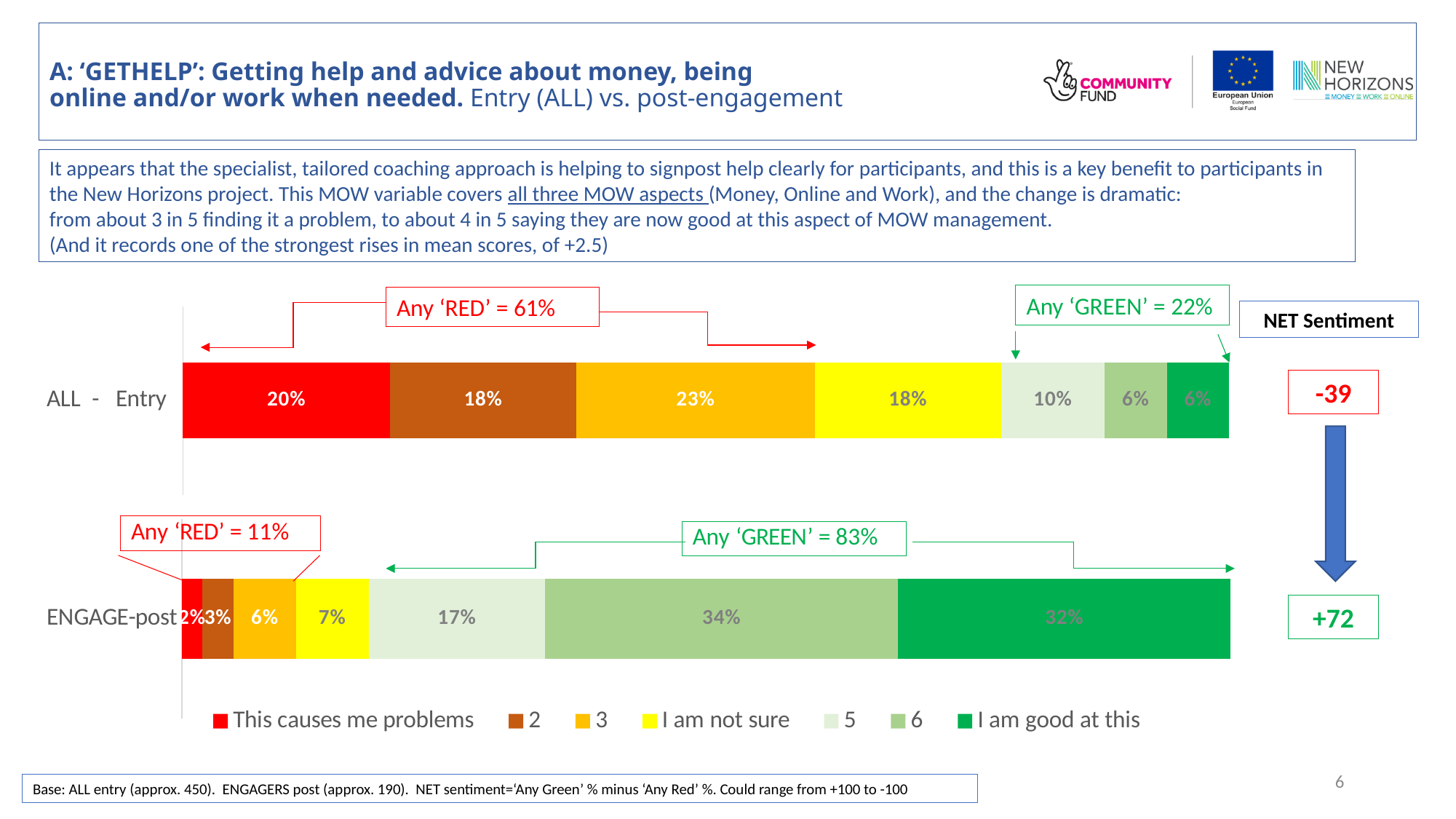
What NET Sentiment value is shown for the ENGAGE-post bar? +72 What kind of chart is shown on the slide? Stacked bar chart Which segment is the smallest in the ENGAGE-post bar? This causes me problems How many bars (categories) are plotted in the chart? 2 Which segment is the largest in the ENGAGE-post bar? 6 How many series does the legend list? 7 What is the value for '6' in the ENGAGE-post bar? 34% What is the value for 'This causes me problems' in the ALL - Entry bar? 20% Which is larger: the '5' value for ALL - Entry or the '5' value for ENGAGE-post? ENGAGE-post What is the value for '3' in the ALL - Entry bar? 23% What is the value for 'I am good at this' in the ENGAGE-post bar? 32% What is the difference between the 'I am not sure' values for ALL - Entry and ENGAGE-post? 11%